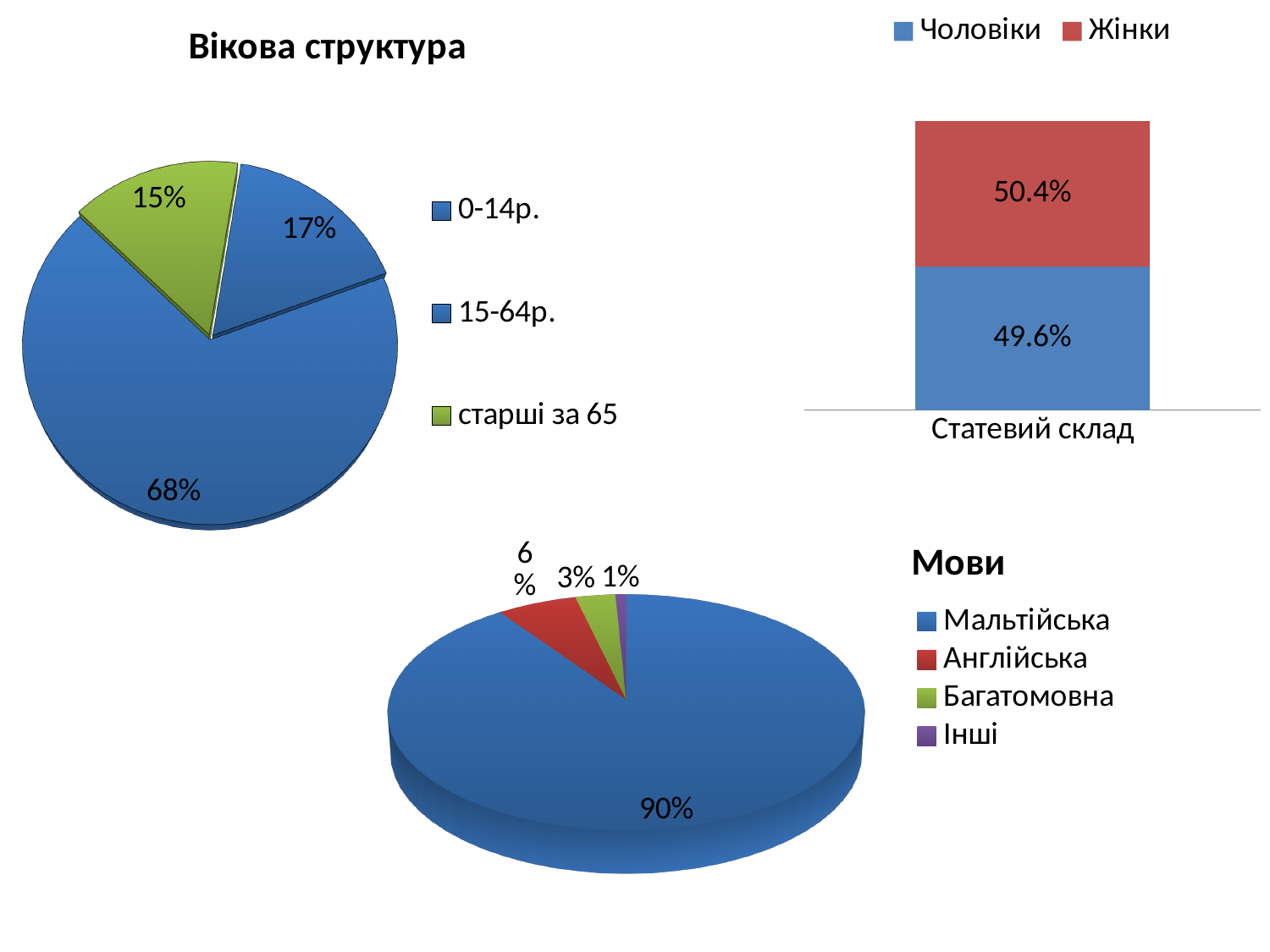
In the "Вікова структура" pie chart, what share is shown for 15-64р.? 68% In the "Мови" pie chart, how many categories does the legend list? 4 In the "Статевий склад" chart, what is the difference between the Жінки and Чоловіки values? 0.8% What kind of chart is the "Статевий склад" chart? Stacked bar chart In the "Мови" pie chart, what is the difference between the Мальтійська and Багатомовна shares? 87% In the "Статевий склад" chart, what is the value for Жінки? 50.4% In the "Мови" pie chart, what share is shown for Англійська? 6% In the "Мови" pie chart, which category has the smallest share? Інші In the "Статевий склад" chart, what is the value for Чоловіки? 49.6% In the "Вікова структура" pie chart, what share is shown for старші за 65? 15% In the "Вікова структура" pie chart, which category has the largest share? 15-64р. In the "Вікова структура" pie chart, how many categories does the legend list? 3